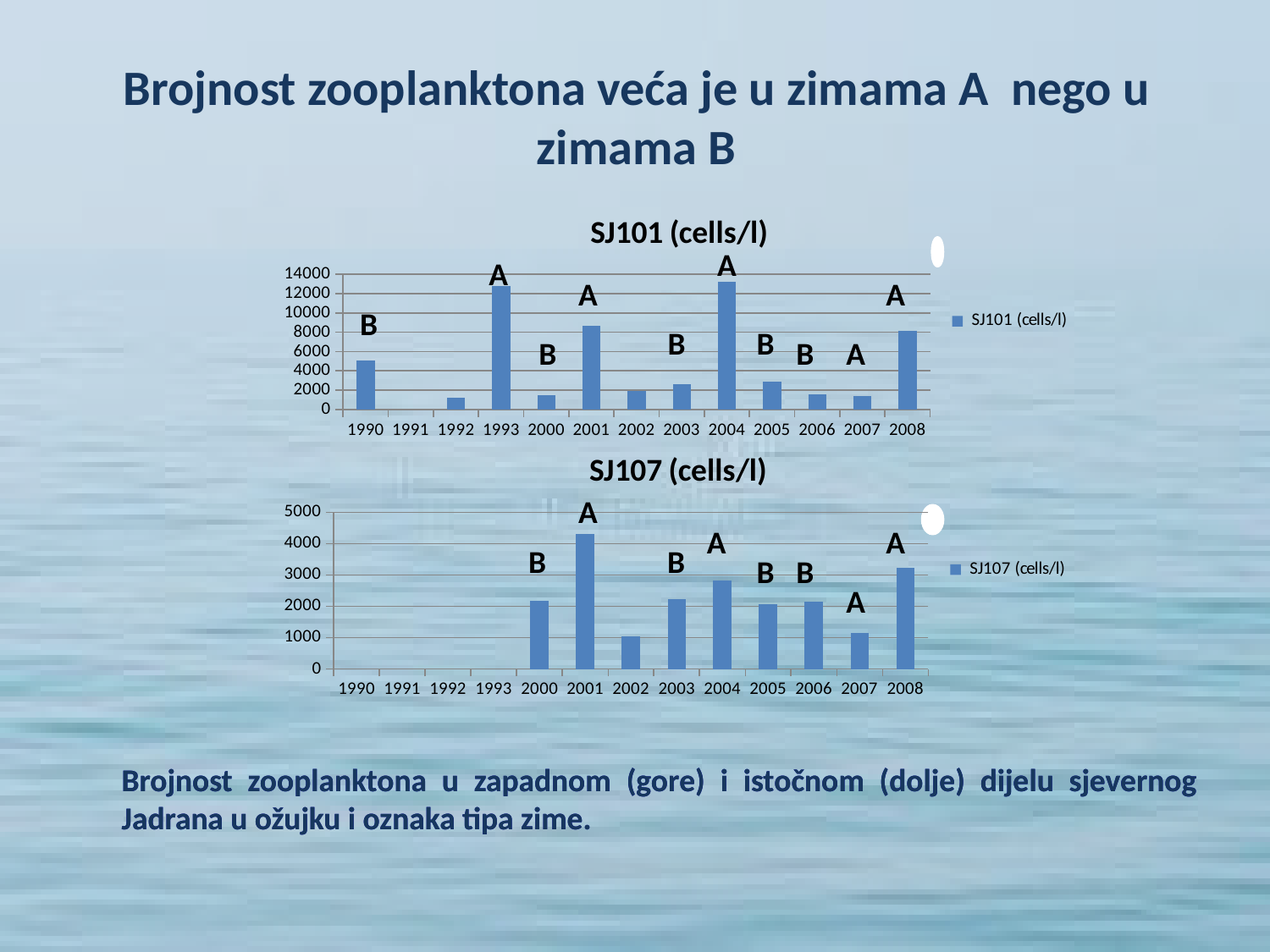
In the top chart "SJ101 (cells/l)", is the value for 1993 greater or less than 12000? greater In the bottom chart "SJ107 (cells/l)", which year has the highest value? 2001 In the top chart "SJ101 (cells/l)", is the value for 1990 greater or less than 6000? less In the bottom chart "SJ107 (cells/l)", which is larger, the value for 2008 or the value for 2004? 2008 In the top chart "SJ101 (cells/l)", what letter is printed above the bar for 2004? A What kind of chart is the top chart titled "SJ101 (cells/l)"? bar chart In the top chart "SJ101 (cells/l)", which is larger, the value for 1993 or the value for 2001? 1993 In the top chart "SJ101 (cells/l)", how many year categories are shown on the x axis? 13 In the top chart "SJ101 (cells/l)", is the value for 2001 greater or less than 8000? greater In the bottom chart "SJ107 (cells/l)", how many series does the legend list? 1